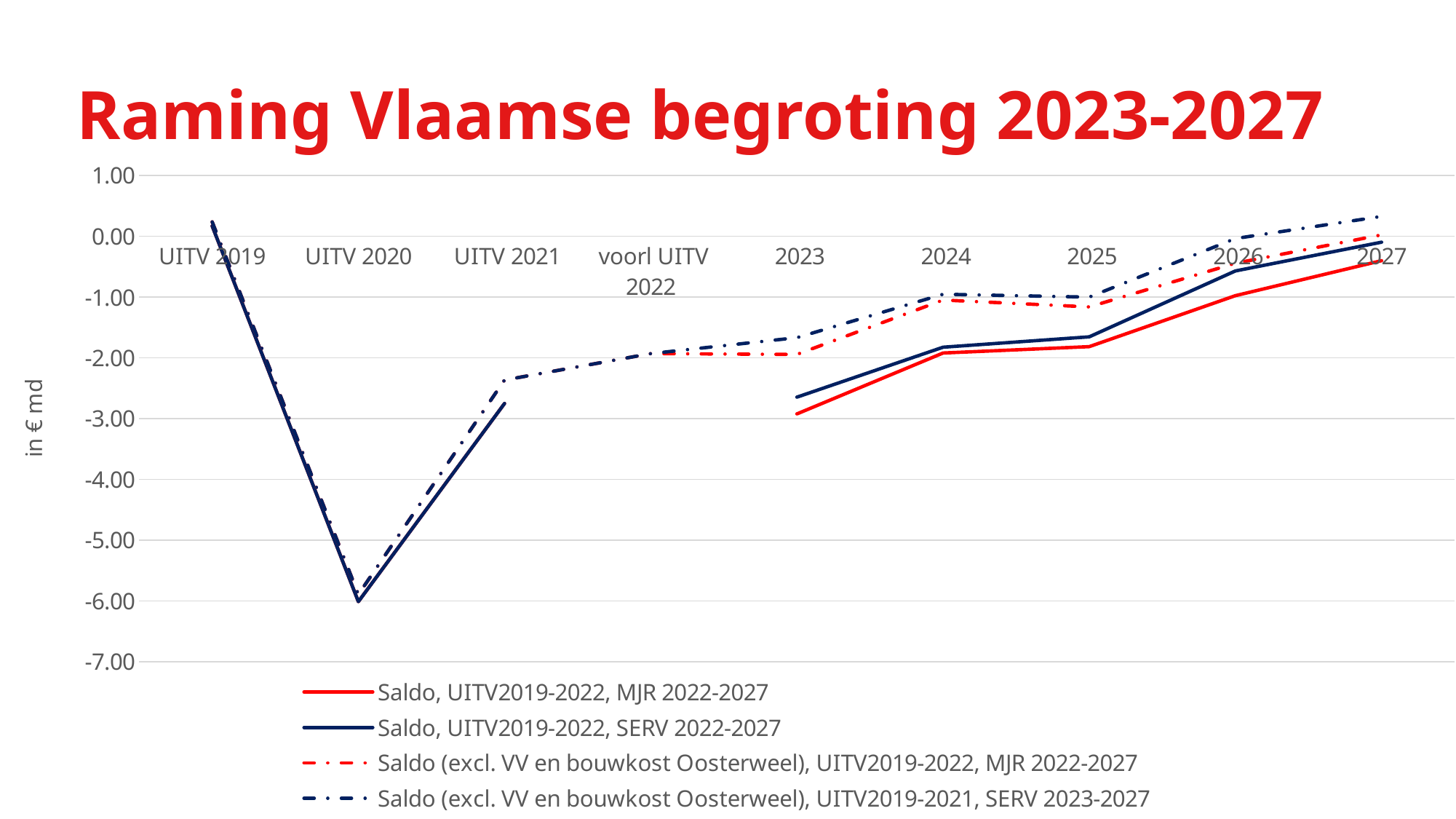
At which category do the lines reach their lowest point? UITV 2020 Is the value of the 'Saldo, UITV2019-2022, MJR 2022-2027' series at 2024 greater or less than -1.00? less How many series does the legend list? 4 What is the title of the chart? Raming Vlaamse begroting 2023-2027 Is the value of the 'Saldo (excl. VV en bouwkost Oosterweel), UITV2019-2021, SERV 2023-2027' series at 2027 greater or less than 0.00? greater What is the label on the vertical axis? in € md Is the value of the 'Saldo, UITV2019-2022, SERV 2022-2027' series at UITV 2020 greater or less than -5.00? less At 2023, which is higher: the 'Saldo, UITV2019-2022, MJR 2022-2027' series or the 'Saldo, UITV2019-2022, SERV 2022-2027' series? Saldo, UITV2019-2022, SERV 2022-2027 How many categories are shown along the x axis? 9 What kind of chart is shown on the slide? line chart Does the 'Saldo, UITV2019-2022, MJR 2022-2027' series rise or fall from 2023 to 2027? rise